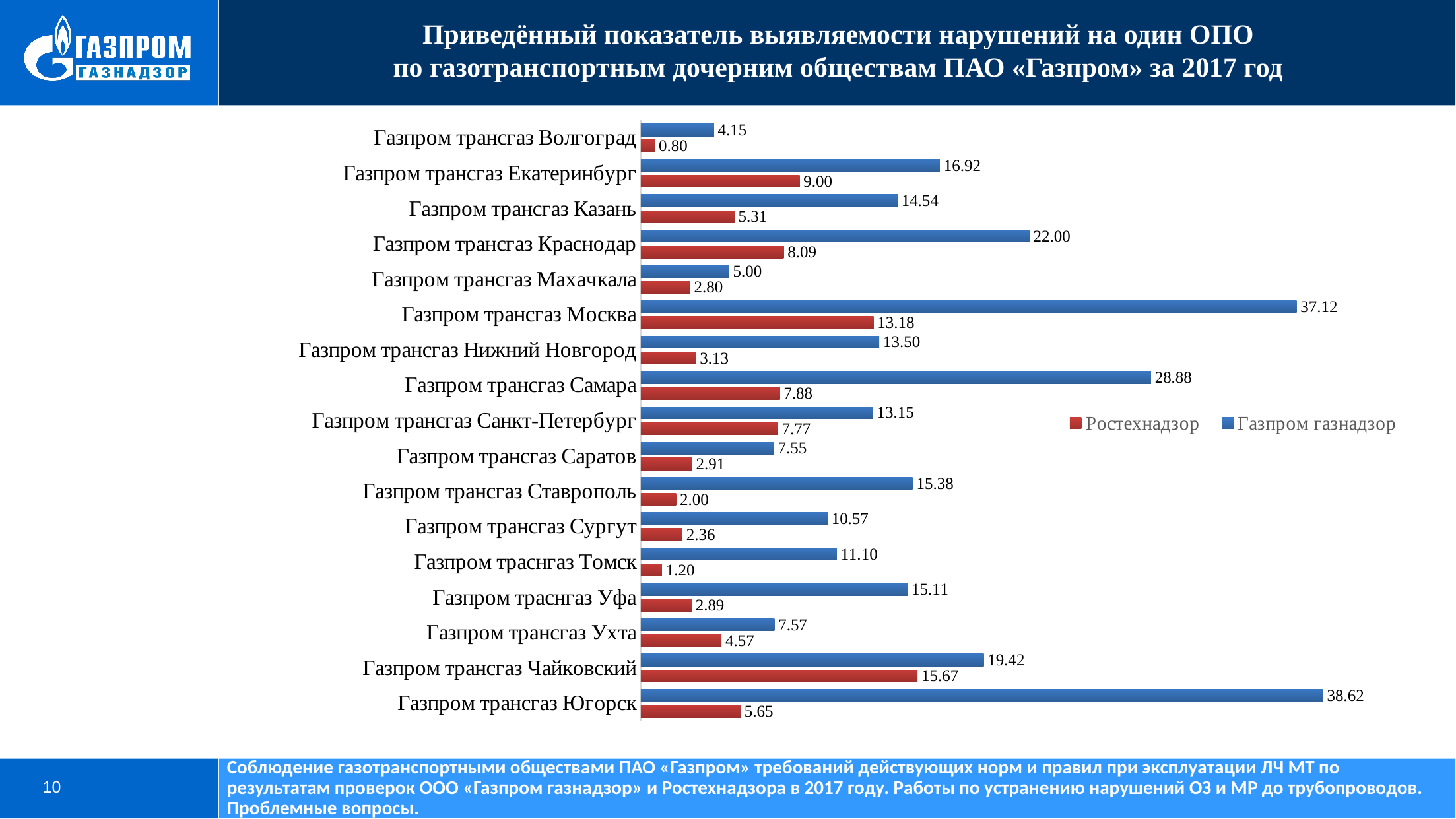
Which colour represents the Ростехнадзор series in the chart? Red How many subsidiaries are shown on the chart? 17 What is the Ростехнадзор value for Газпром трансгаз Чайковский? 15.67 What kind of chart is shown on the slide? Bar chart Which subsidiary has the highest Газпром газнадзор value? Газпром трансгаз Югорск What is the Ростехнадзор value for Газпром трансгаз Волгоград? 0.80 What is the difference between the Газпром газнадзор and Ростехнадзор values for Газпром трансгаз Москва? 23.94 Which is larger for Газпром трансгаз Краснодар: the Газпром газнадзор value or the Ростехнадзор value? Газпром газнадзор Which subsidiary has the lowest Ростехнадзор value? Газпром трансгаз Волгоград How many series does the legend list? 2 What is the Газпром газнадзор value for Газпром трансгаз Москва? 37.12 Which subsidiary has the highest Ростехнадзор value? Газпром трансгаз Чайковский